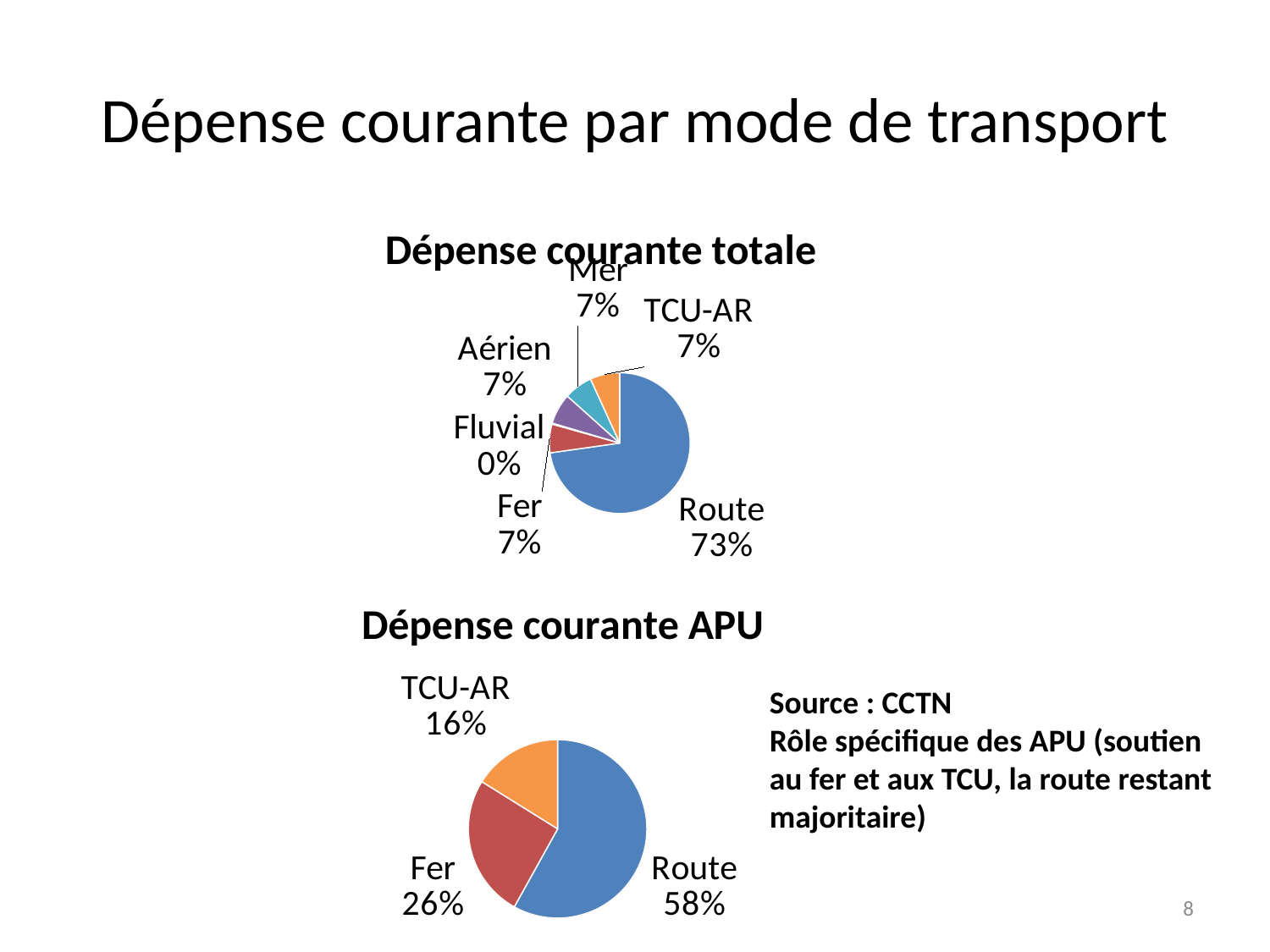
In the 'Dépense courante totale' chart, what share does Route have? 73% In the 'Dépense courante APU' chart, what is the difference between the Route share and the Fer share? 32% In the 'Dépense courante totale' chart, which category has the smallest share? Fluvial In the 'Dépense courante APU' chart, what share does Fer have? 26% How many categories are shown in the 'Dépense courante totale' chart? 6 In the 'Dépense courante APU' chart, what share does TCU-AR have? 16% How many categories are shown in the 'Dépense courante APU' chart? 3 In the 'Dépense courante APU' chart, which category has the largest share? Route Which is larger: the Route share in 'Dépense courante totale' or the Route share in 'Dépense courante APU'? Dépense courante totale In the 'Dépense courante totale' chart, which category has the largest share? Route What kind of chart is 'Dépense courante totale'? Pie chart